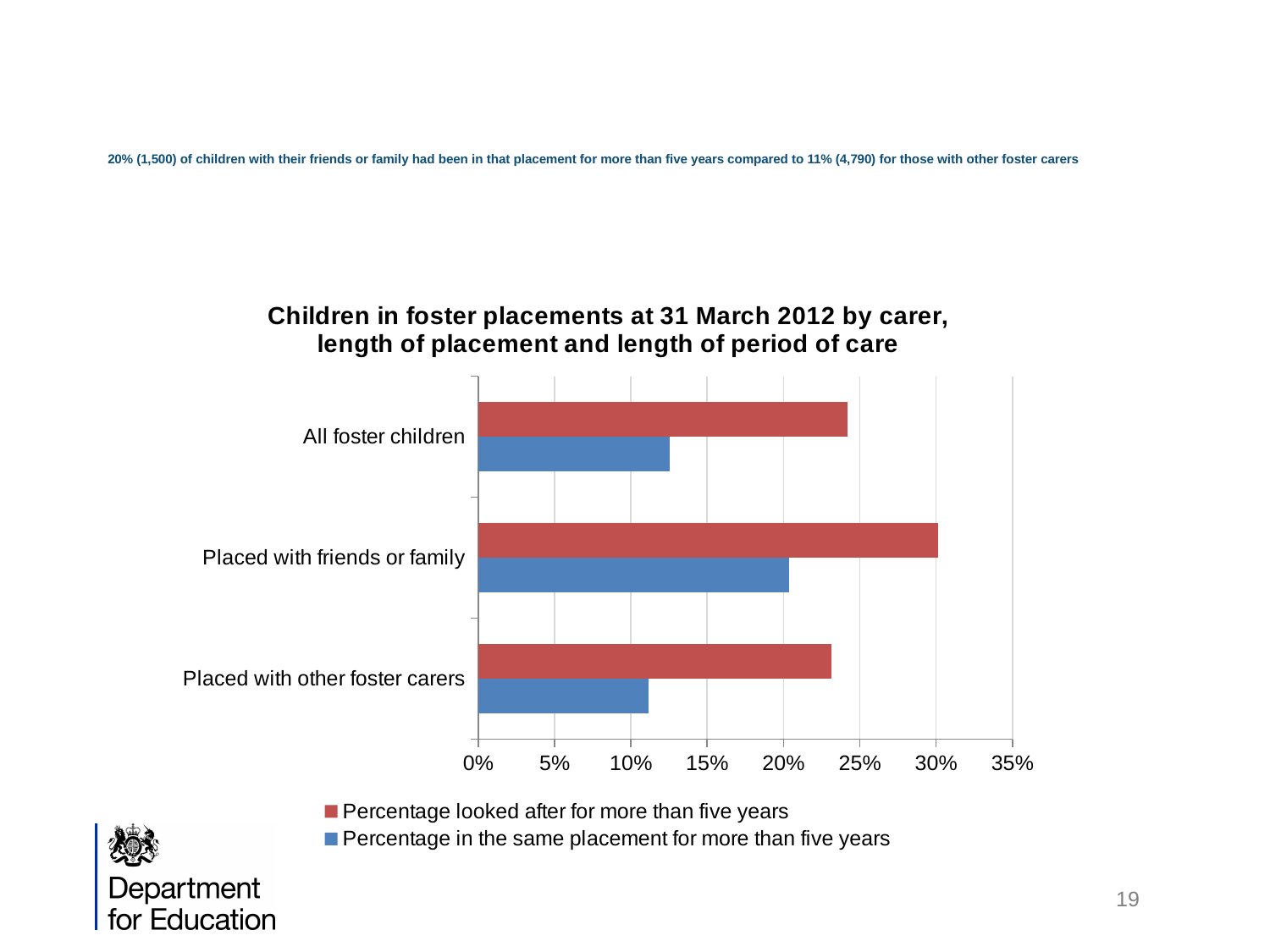
Which series is shown in blue? Percentage in the same placement for more than five years Is the percentage looked after for more than five years for 'All foster children' greater or less than 20%? greater What is the title of the chart? Children in foster placements at 31 March 2012 by carer, length of placement and length of period of care How many series does the legend list? 2 Which is larger: the percentage looked after for more than five years for 'Placed with friends or family' or for 'Placed with other foster carers'? Placed with friends or family Which category has the highest percentage looked after for more than five years? Placed with friends or family Which category has the highest percentage in the same placement for more than five years? Placed with friends or family Is the percentage in the same placement for more than five years for 'All foster children' greater or less than 15%? less How many categories are shown on the chart? 3 What kind of chart is shown on the slide? Bar chart Is the percentage in the same placement for more than five years for 'Placed with other foster carers' greater or less than 15%? less